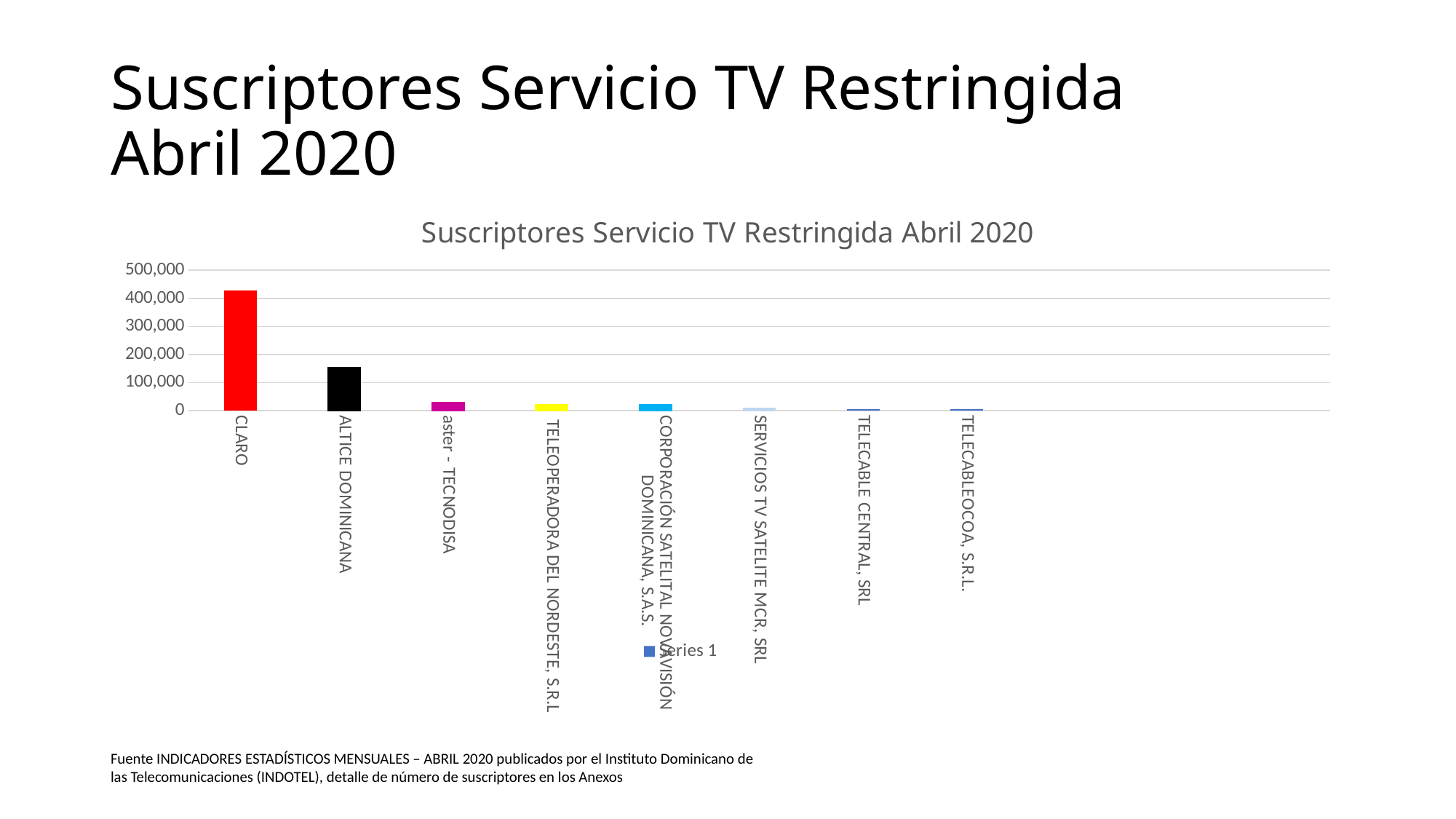
What colour is the bar for CLARO? red Which has more subscribers, CLARO or ALTICE DOMINICANA? CLARO Which company has the highest number of subscribers? CLARO How many series does the legend list? 1 Is the value for ALTICE DOMINICANA greater or less than 100,000? greater Which has more subscribers, ALTICE DOMINICANA or aster - TECNODISA? ALTICE DOMINICANA What kind of chart is shown on the slide? bar chart Is the value for aster - TECNODISA greater or less than 100,000? less What is the title of the chart? Suscriptores Servicio TV Restringida Abril 2020 How many categories (companies) are plotted on the chart? 8 Is the value for ALTICE DOMINICANA greater or less than 200,000? less